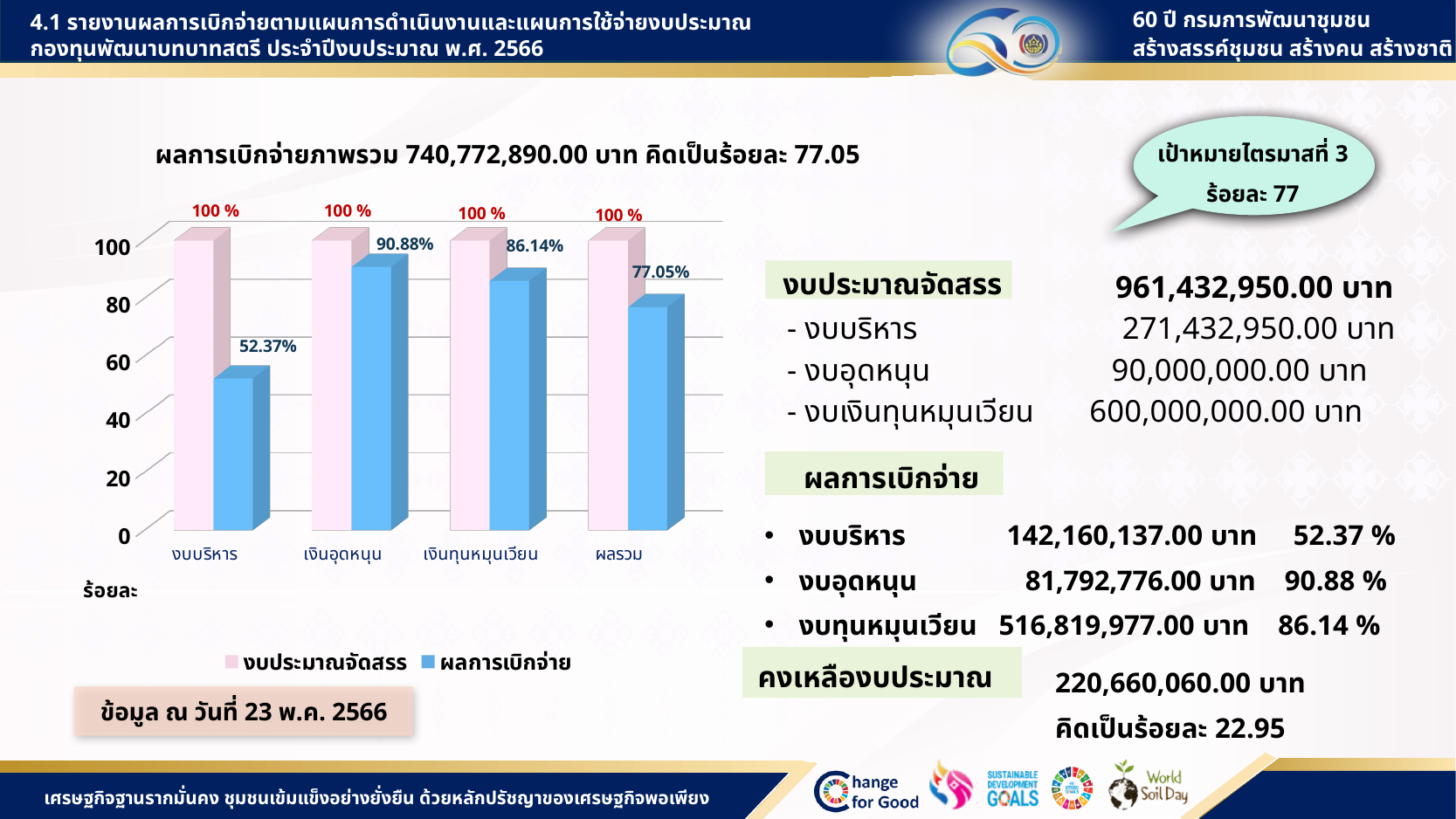
Which category has the highest ผลการเบิกจ่าย value? เงินอุดหนุน What is the ผลการเบิกจ่าย value for งบบริหาร? 52.37% How many series does the chart legend list? 2 What is the ผลการเบิกจ่าย value for เงินอุดหนุน? 90.88% Which category has the lowest ผลการเบิกจ่าย value? งบบริหาร What type of chart is shown on the slide? bar chart What is the ผลการเบิกจ่าย value for เงินทุนหมุนเวียน? 86.14% What is the difference between the ผลการเบิกจ่าย values for เงินอุดหนุน and งบบริหาร? 38.51% What is the ผลการเบิกจ่าย value for ผลรวม? 77.05% Which series is shown in blue in the chart legend? ผลการเบิกจ่าย What is the งบประมาณจัดสรร value for เงินอุดหนุน? 100 % How many categories are shown on the x axis of the chart? 4